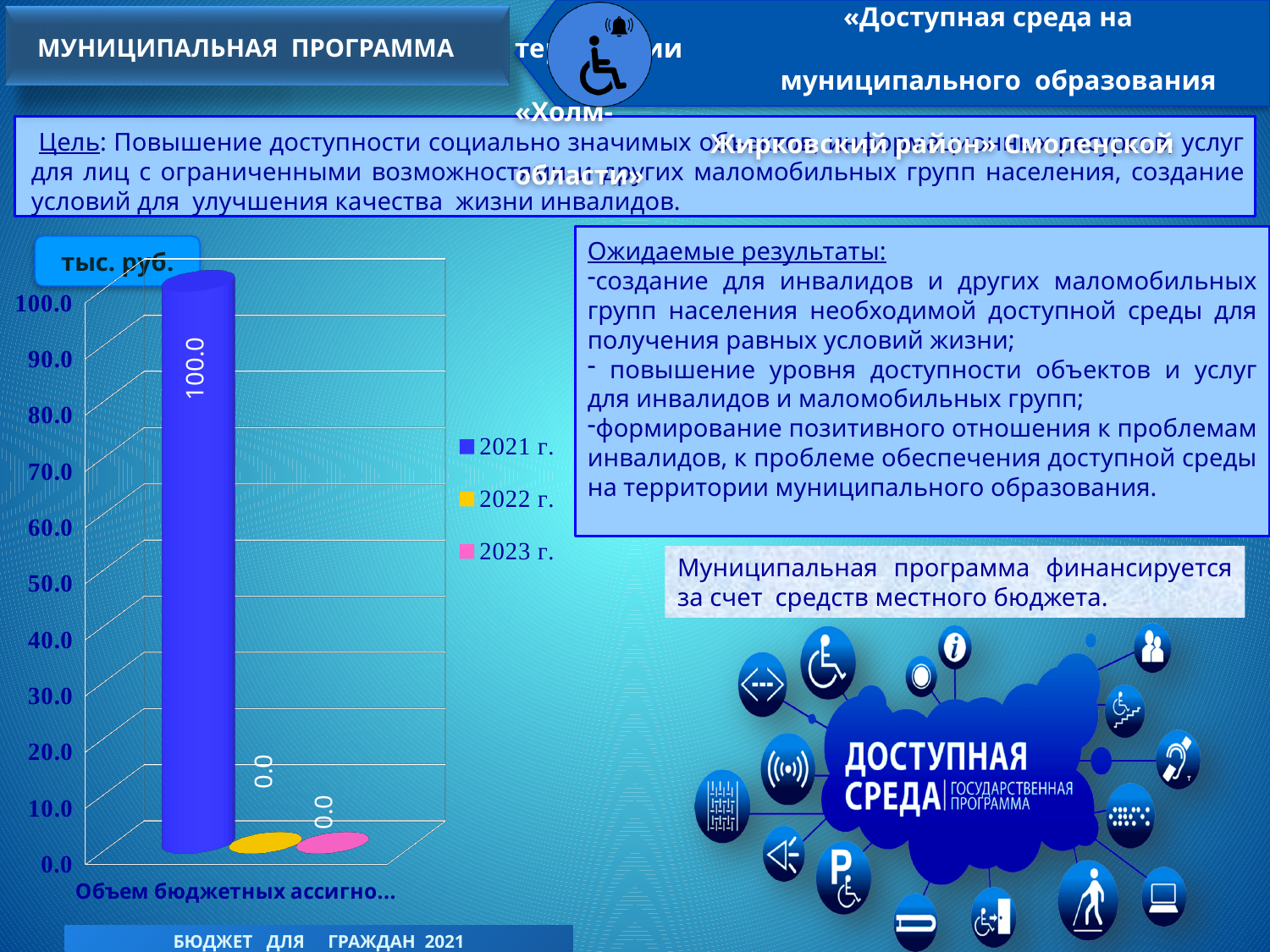
What is the total of the values for 2021 г., 2022 г. and 2023 г.? 100.0 What kind of chart is shown on the slide? bar chart What is the difference between the values for 2021 г. and 2022 г.? 100.0 What is the highest value shown on the chart's vertical axis? 100.0 What is the value for 2022 г. in the chart? 0.0 Which is larger, the value for 2021 г. or the value for 2023 г.? 2021 г. Is the value for 2021 г. greater or less than 50.0? greater What unit is shown in the label above the chart? тыс. руб. How many series does the chart legend list? 3 Which series has the highest value in the chart? 2021 г. What is the value for 2021 г. in the chart? 100.0 What is the value for 2023 г. in the chart? 0.0